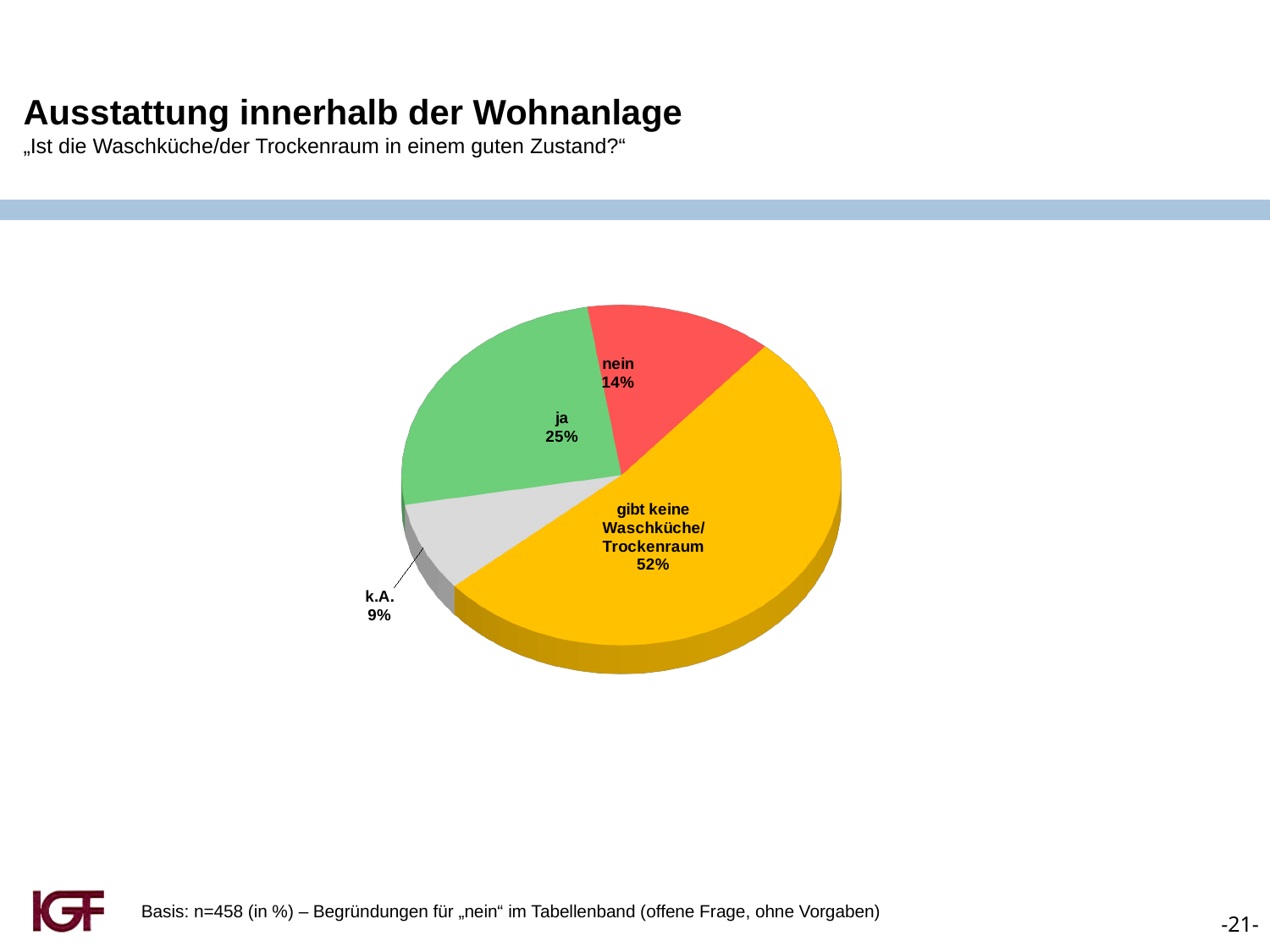
What percentage of respondents answered "ja"? 25% What type of chart is shown on the slide? pie chart What is the difference in percentage points between "ja" and "nein"? 11 What colour is the slice for "nein"? red What is the difference in percentage points between "gibt keine Waschküche/Trockenraum" and "ja"? 27 Which slice of the pie is the largest? gibt keine Waschküche/Trockenraum Which is larger, the share for "ja" or the share for "nein"? ja Which slice of the pie is the smallest? k.A. What percentage is shown for "k.A."? 9% What percentage of respondents answered "nein"? 14% What share of the pie is labelled "gibt keine Waschküche/Trockenraum"? 52% How many slices does the pie chart have? 4